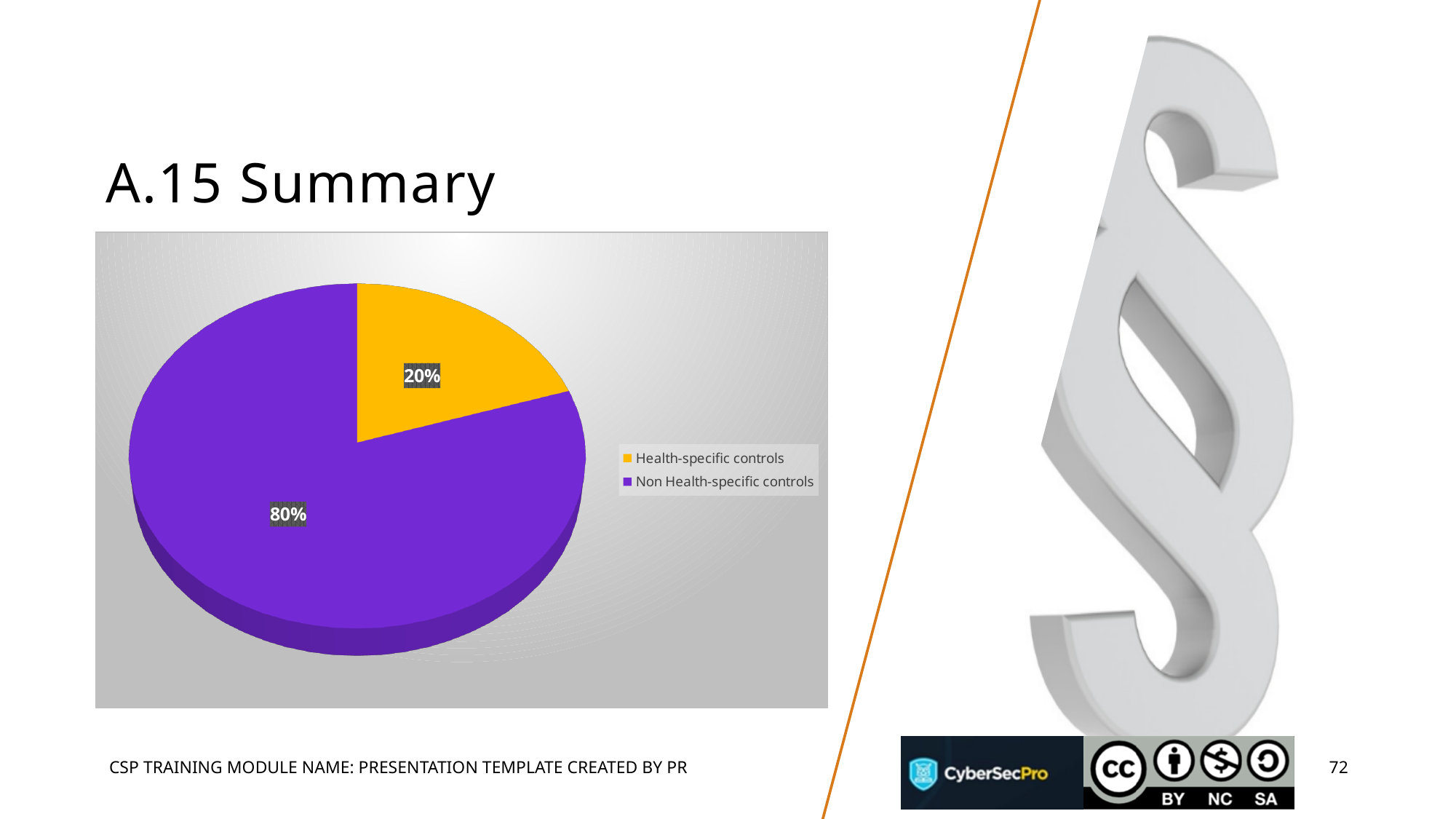
What share of the pie is Health-specific controls? 20% Which category has the largest slice of the pie? Non Health-specific controls Which is larger, the share for Health-specific controls or the share for Non Health-specific controls? Non Health-specific controls What is the difference in percentage points between Non Health-specific controls and Health-specific controls? 60 How many entries does the legend list? 2 How many slices does the pie chart have? 2 What share of the pie is Non Health-specific controls? 80% What colour is the Non Health-specific controls slice? Purple Which category has the smallest slice of the pie? Health-specific controls What colour is the Health-specific controls slice? Orange What kind of chart is shown on the slide? Pie chart